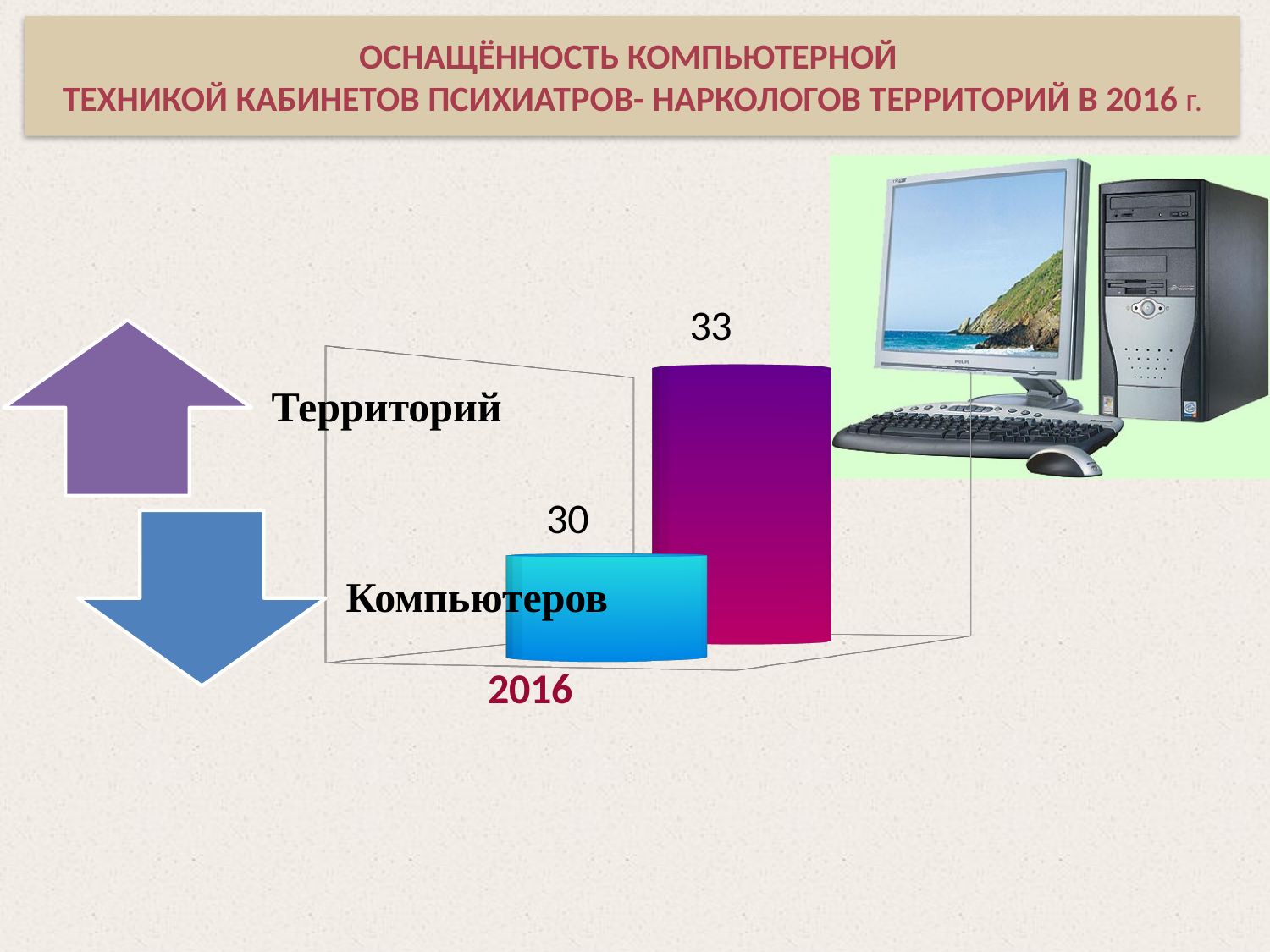
What is the difference between the value for Территорий and the value for Компьютеров? 3 Which series has the highest value on the chart? Территорий Which series has the lowest value on the chart? Компьютеров What is the value for Территорий in 2016? 33 How many series are plotted on the chart? 2 Which year is shown on the x axis of the chart? 2016 What is the value for Компьютеров in 2016? 30 What kind of chart is shown on the slide? Bar chart Which series has the higher value, Территорий or Компьютеров? Территорий What colour is the bar for Компьютеров? Blue How many categories are shown on the x axis of the chart? 1